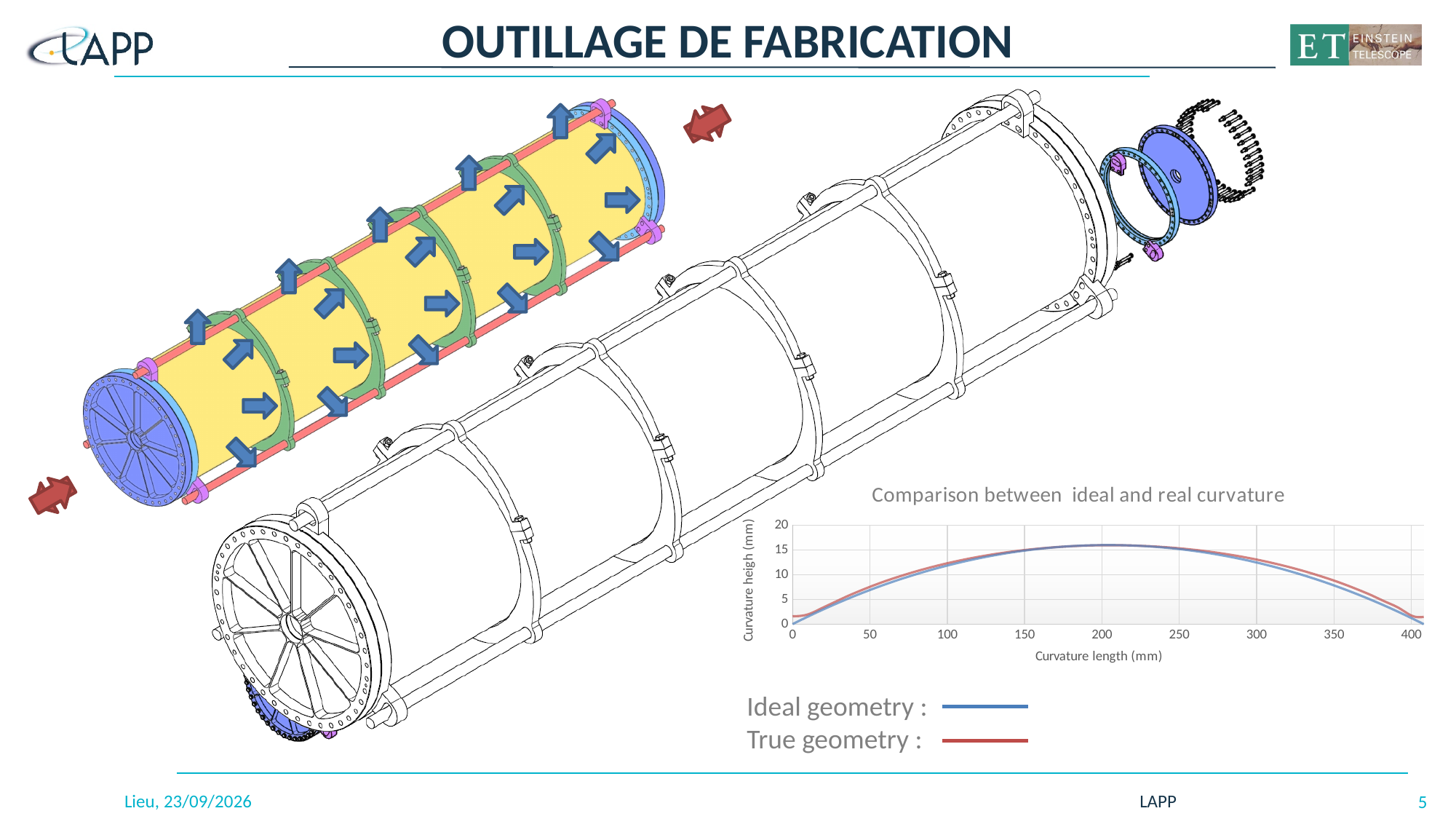
In the chart, do the curvature height values rise or fall as the curvature length goes from 250 to 400 mm? fall In the chart, is the curvature height for Ideal geometry at a curvature length of 200 mm greater or less than 10? greater What is the title of the chart on the slide? Comparison between ideal and real curvature In the chart, is the curvature height for True geometry at a curvature length of 100 mm greater or less than 5? greater What kind of chart is shown on the slide? line chart In the chart, do the curvature height values rise or fall as the curvature length goes from 0 to 200 mm? rise What colour is the line for Ideal geometry in the chart? blue In the chart, is the curvature height for Ideal geometry at a curvature length of 300 mm greater or less than 20? less How many series does the legend of the chart list? 2